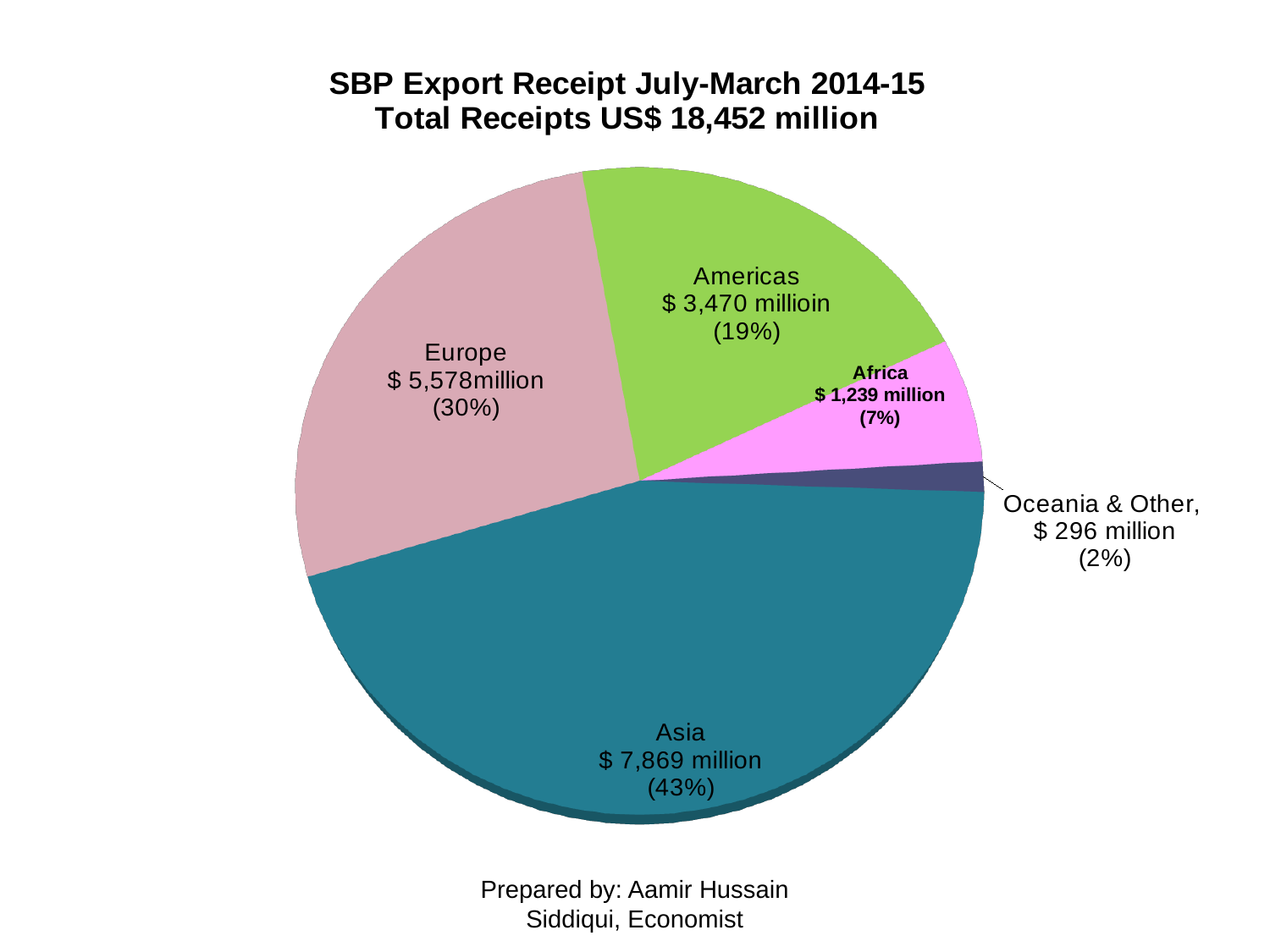
What is the difference between the export receipts for Asia and Europe? $ 2,291 million What is the export receipt value for Europe? $ 5,578 million What is the export receipt value for Oceania & Other? $ 296 million What is the export receipt value for Africa? $ 1,239 million What type of chart is shown on the slide? pie chart What percentage share of export receipts does the Americas slice represent? 19% Which region has higher export receipts, Americas or Africa? Americas Which region has the smallest share of export receipts? Oceania & Other What percentage share of export receipts does the Europe slice represent? 30% What is the export receipt value for Asia? $ 7,869 million How many regions are shown in the pie chart? 5 Which region has the largest share of export receipts? Asia